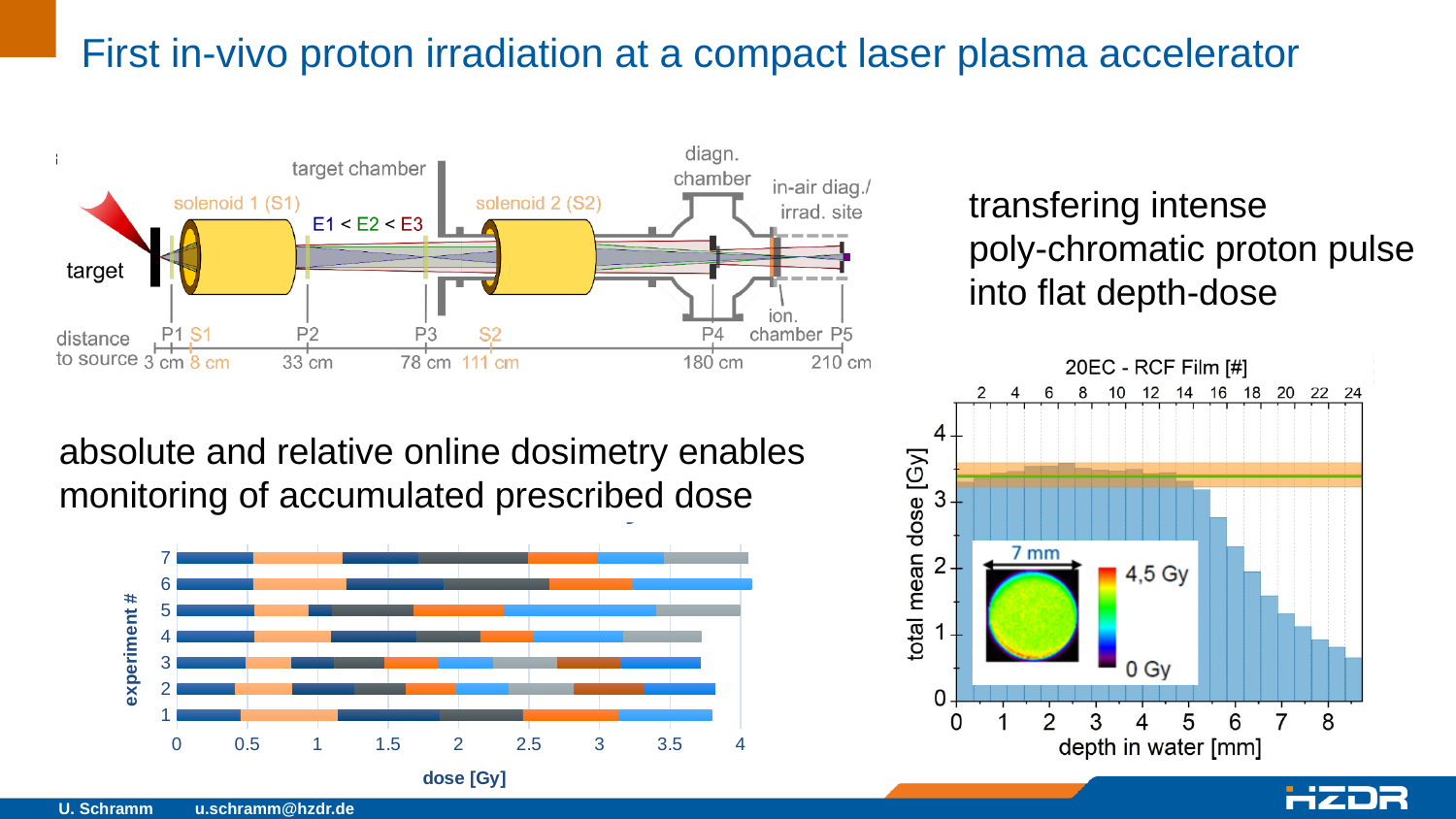
In the bottom-left stacked bar chart, is the total dose for experiment 1 greater or less than 3.5? greater In the bottom-left stacked bar chart, is the total dose for experiment 4 greater or less than 4? less In the right-hand depth-dose chart, what is the label of the vertical axis? total mean dose [Gy] What kind of chart is the chart at the bottom left with 'experiment #' on the vertical axis? stacked bar chart In the right-hand depth-dose chart, is the total mean dose at a depth of 7 mm greater or less than 2 Gy? less In the bottom-left stacked bar chart, how many experiments are plotted on the vertical axis? 7 In the bottom-left stacked bar chart, what is the label of the horizontal axis? dose [Gy] In the right-hand depth-dose chart, does the total mean dose rise or fall as the depth in water increases beyond about 5 mm? fall What kind of chart is the chart on the right showing total mean dose versus depth in water? bar chart